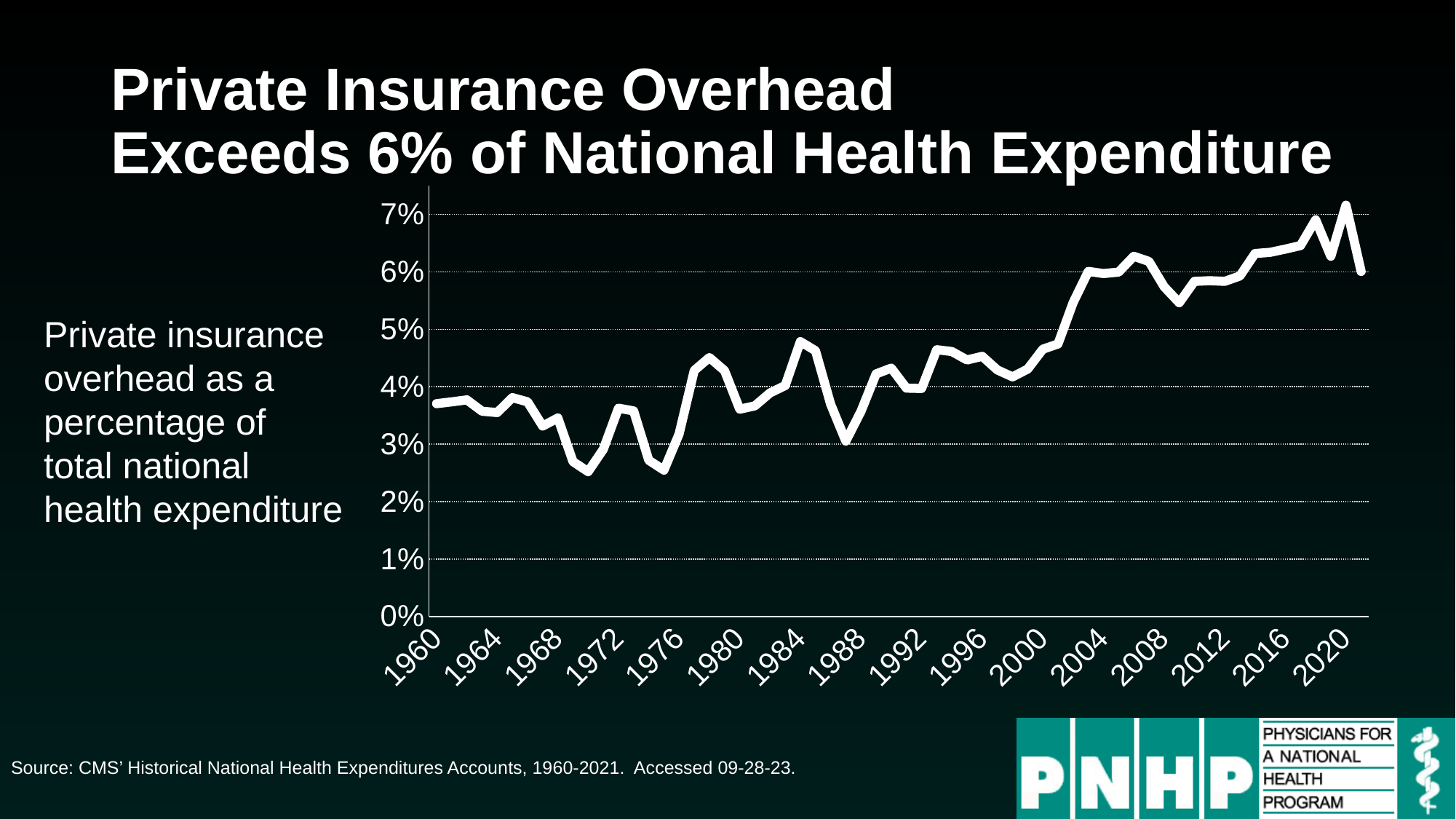
Is the value for 1960 greater or less than 4%? less Is the value for 2012 greater or less than 5%? greater Is the value for 1960 greater or less than 3%? greater Overall, does the line rise or fall from 1960 to 2020? rise Which is larger, the value for 1976 or the value for 1996? 1996 What does the line in the chart represent, according to the text on the slide? Private insurance overhead as a percentage of total national health expenditure Which is larger, the value for 1960 or the value for 2020? 2020 What is the title of the slide containing the chart? Private Insurance Overhead Exceeds 6% of National Health Expenditure What kind of chart is shown on the slide? line chart